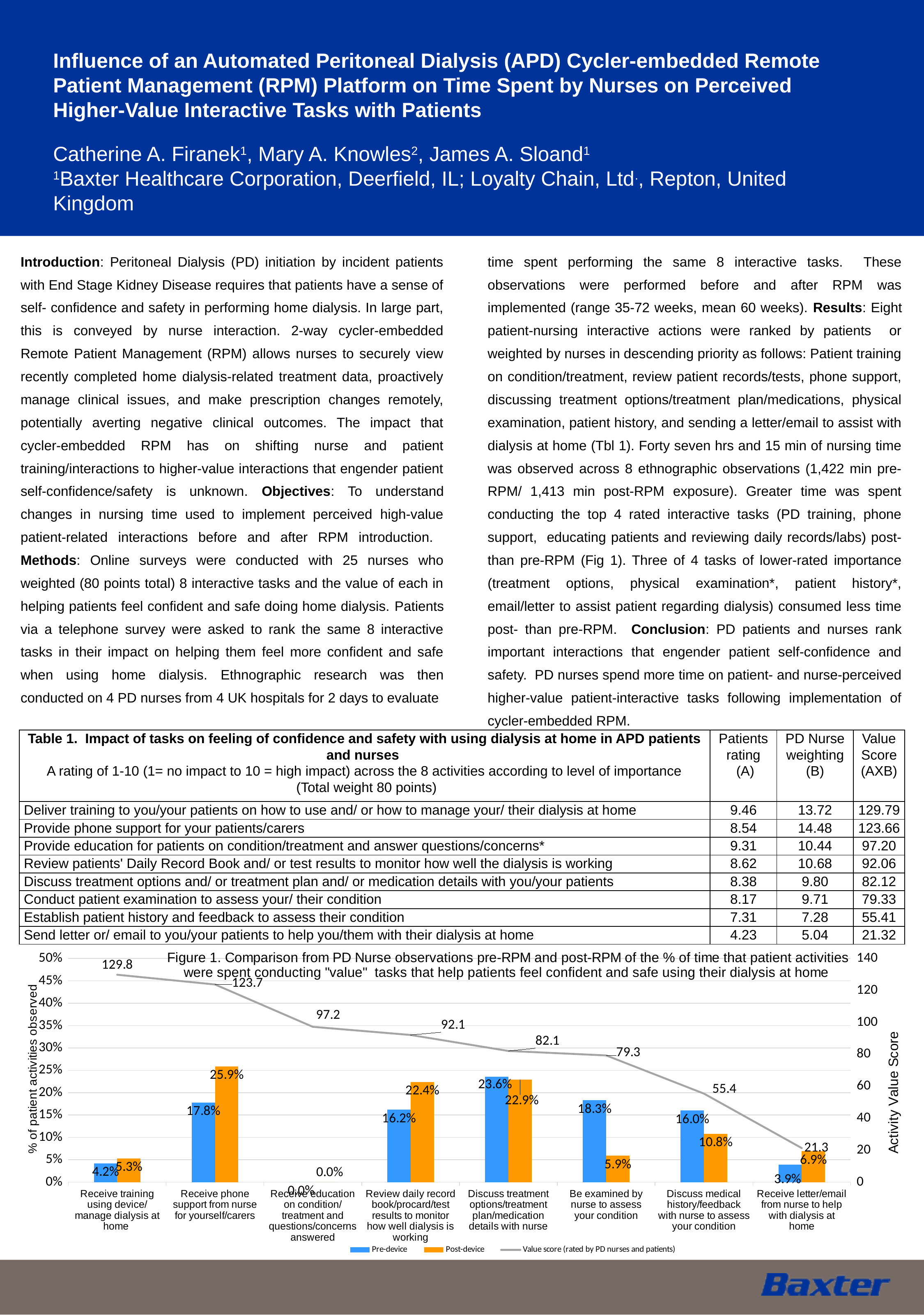
What is the Pre-device value for "Receive phone support from nurse for yourself/carers"? 17.8% What is the difference between the Post-device and Pre-device values for "Receive phone support from nurse for yourself/carers"? 8.1% Which category has the lowest value score? Receive letter/email from nurse to help with dialysis at home For "Discuss medical history/feedback with nurse to assess your condition", which is larger, the Pre-device or the Post-device value? Pre-device What is the value score for "Review daily record book/procard/test results to monitor how well dialysis is working"? 92.1 What is the Pre-device value for "Discuss treatment options/treatment plan/medication details with nurse"? 23.6% Which category has the highest Post-device value? Receive phone support from nurse for yourself/carers Does the value score line rise or fall from left to right across the categories? fall What is the Post-device value for "Be examined by nurse to assess your condition"? 5.9% What is the label of the right-hand vertical axis of the chart? Activity Value Score How many series does the legend list? 3 How many categories are shown on the x axis of the chart? 8